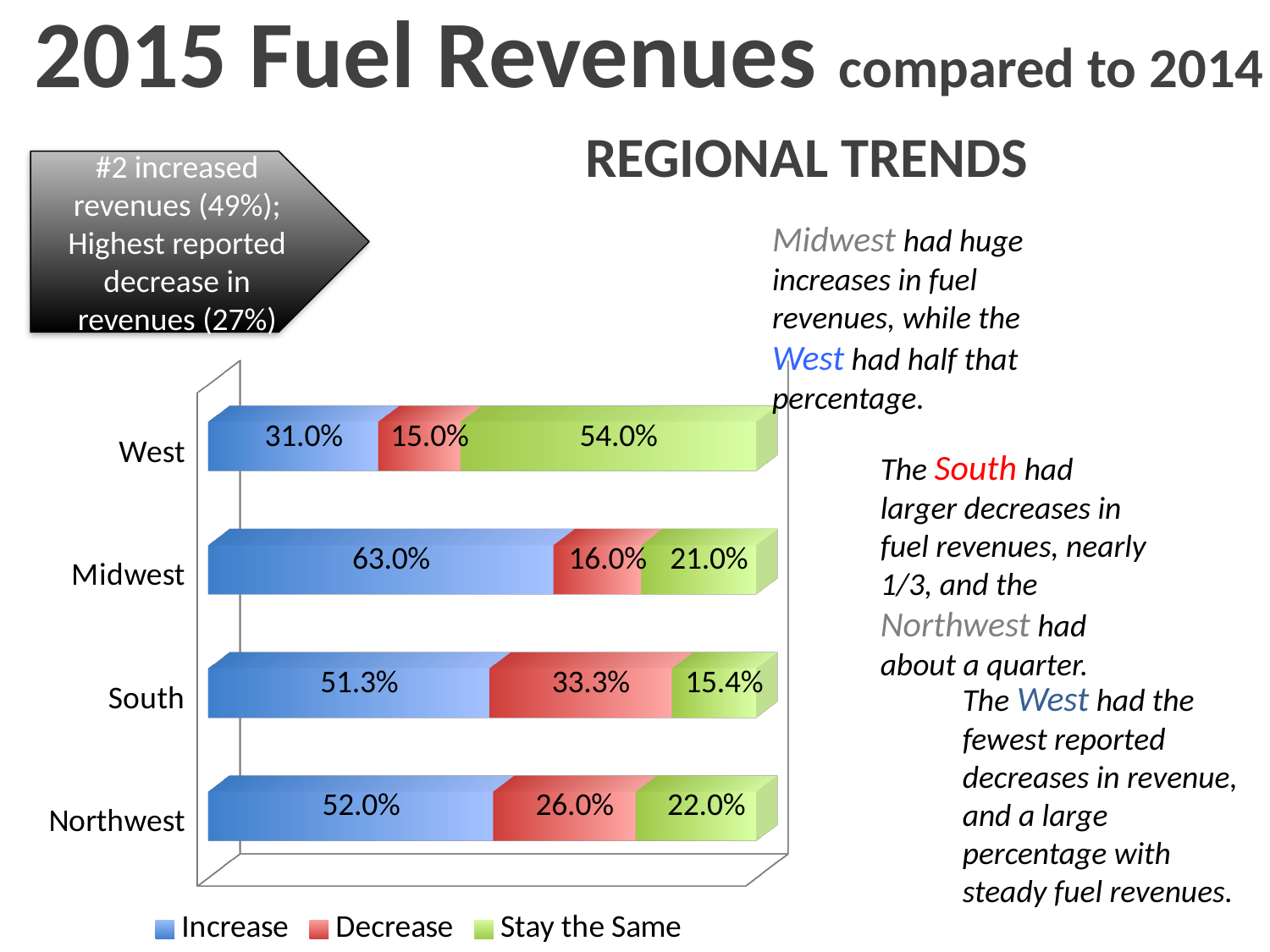
What is the total of the stacked bar for the South? 100.0% Which region has the lowest Decrease value? West What is the difference between the Decrease values for the South and the West? 18.3% Which region has the highest Increase value? Midwest Which is larger, the Stay the Same value for the Northwest or for the Midwest? Northwest What is the Stay the Same value for the West? 54.0% How many regions are shown in the chart? 4 What type of chart is shown on the slide? Stacked bar chart What percentage of the Midwest reported an increase in fuel revenues? 63.0% How many series does the legend list? 3 What is the Decrease value for the South? 33.3% What is the Increase value for the Northwest? 52.0%